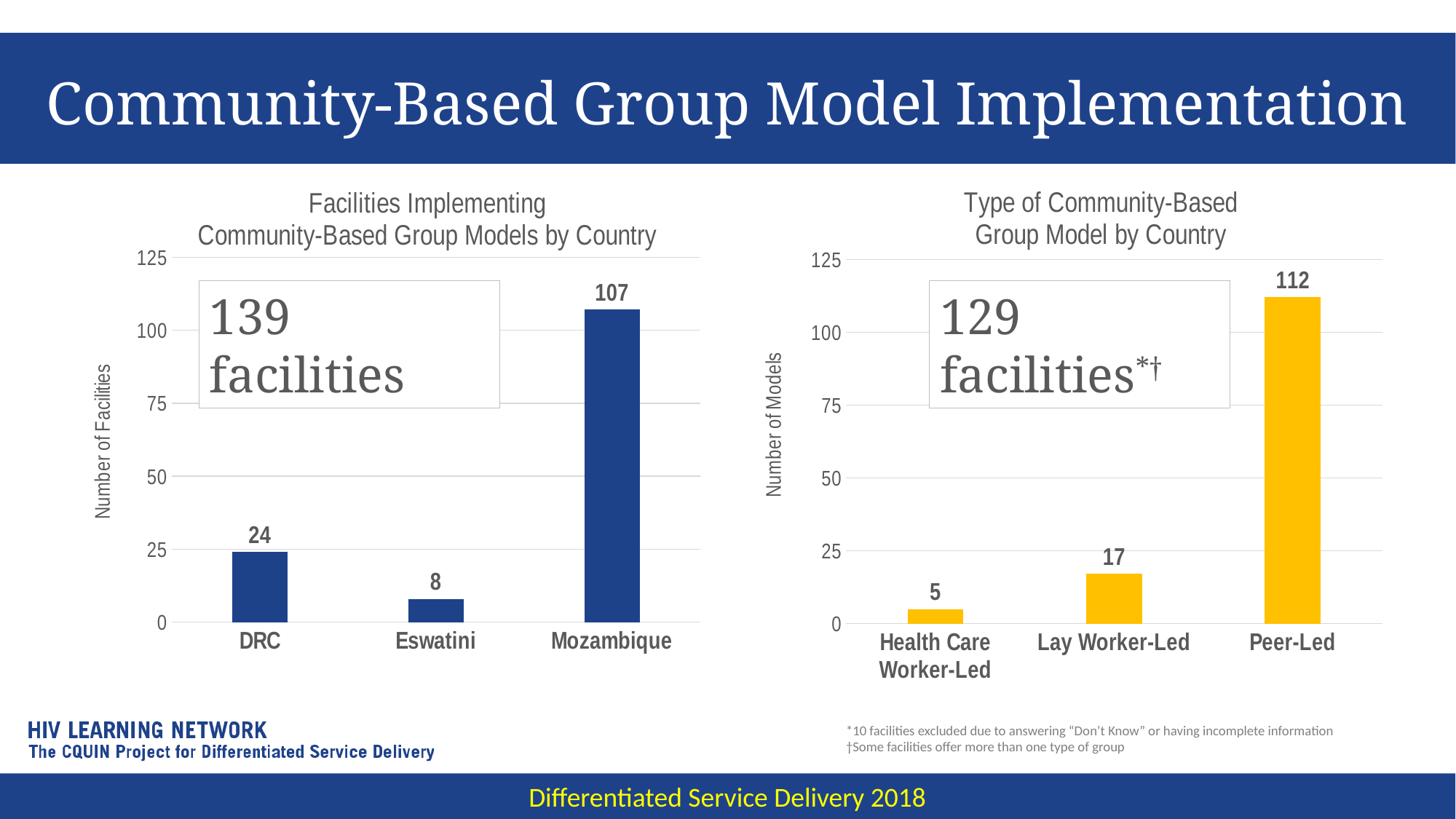
What is the y-axis label of the 'Facilities Implementing Community-Based Group Models by Country' chart? Number of Facilities In the 'Type of Community-Based Group Model by Country' chart, what is the value for Health Care Worker-Led? 5 In the 'Type of Community-Based Group Model by Country' chart, which is larger: Lay Worker-Led or Health Care Worker-Led? Lay Worker-Led In the 'Facilities Implementing Community-Based Group Models by Country' chart, what is the value for Mozambique? 107 In the 'Facilities Implementing Community-Based Group Models by Country' chart, what is the value for Eswatini? 8 In the 'Facilities Implementing Community-Based Group Models by Country' chart, which country has the lowest value? Eswatini What kind of chart is the 'Type of Community-Based Group Model by Country' chart? Bar chart In the 'Type of Community-Based Group Model by Country' chart, what is the difference between Peer-Led and Lay Worker-Led? 95 In the 'Type of Community-Based Group Model by Country' chart, what is the value for Lay Worker-Led? 17 In the 'Type of Community-Based Group Model by Country' chart, which category has the highest value? Peer-Led In the 'Facilities Implementing Community-Based Group Models by Country' chart, how many countries are shown? 3 In the 'Facilities Implementing Community-Based Group Models by Country' chart, what is the difference between Mozambique and DRC? 83